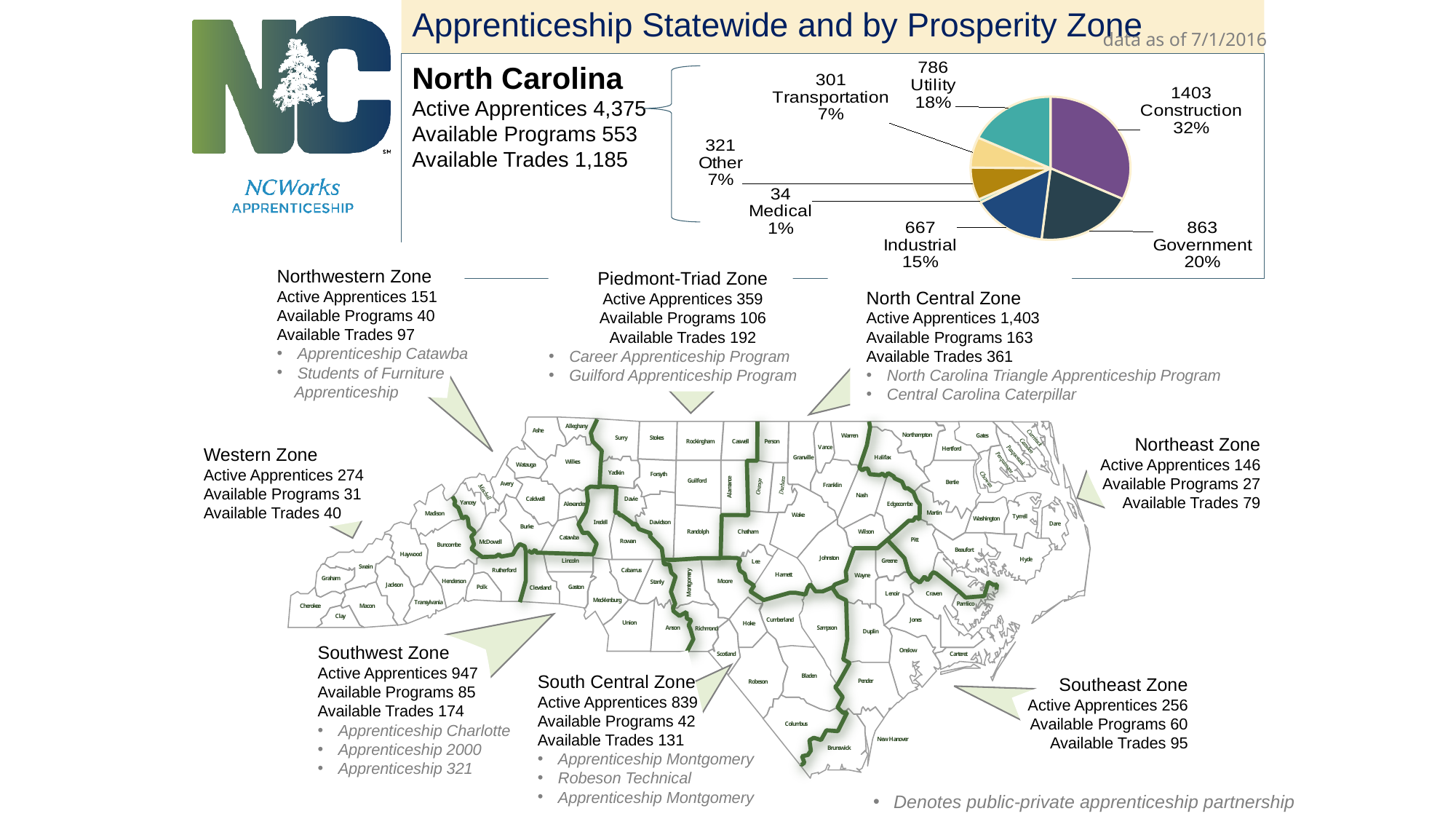
What percentage share does Government have in the pie chart? 20% What is the difference between the Construction and Government values in the pie chart? 540 What is the value for Utility in the pie chart? 786 What percentage share does Industrial have in the pie chart? 15% What is the difference between the Other and Transportation values in the pie chart? 20 Which is larger in the pie chart, Industrial or Utility? Utility What kind of chart is shown on the slide? pie chart How many slices does the pie chart have? 7 What is the value for Medical in the pie chart? 34 Which category has the largest slice in the pie chart? Construction Which category has the smallest slice in the pie chart? Medical What is the value for Construction in the pie chart? 1403